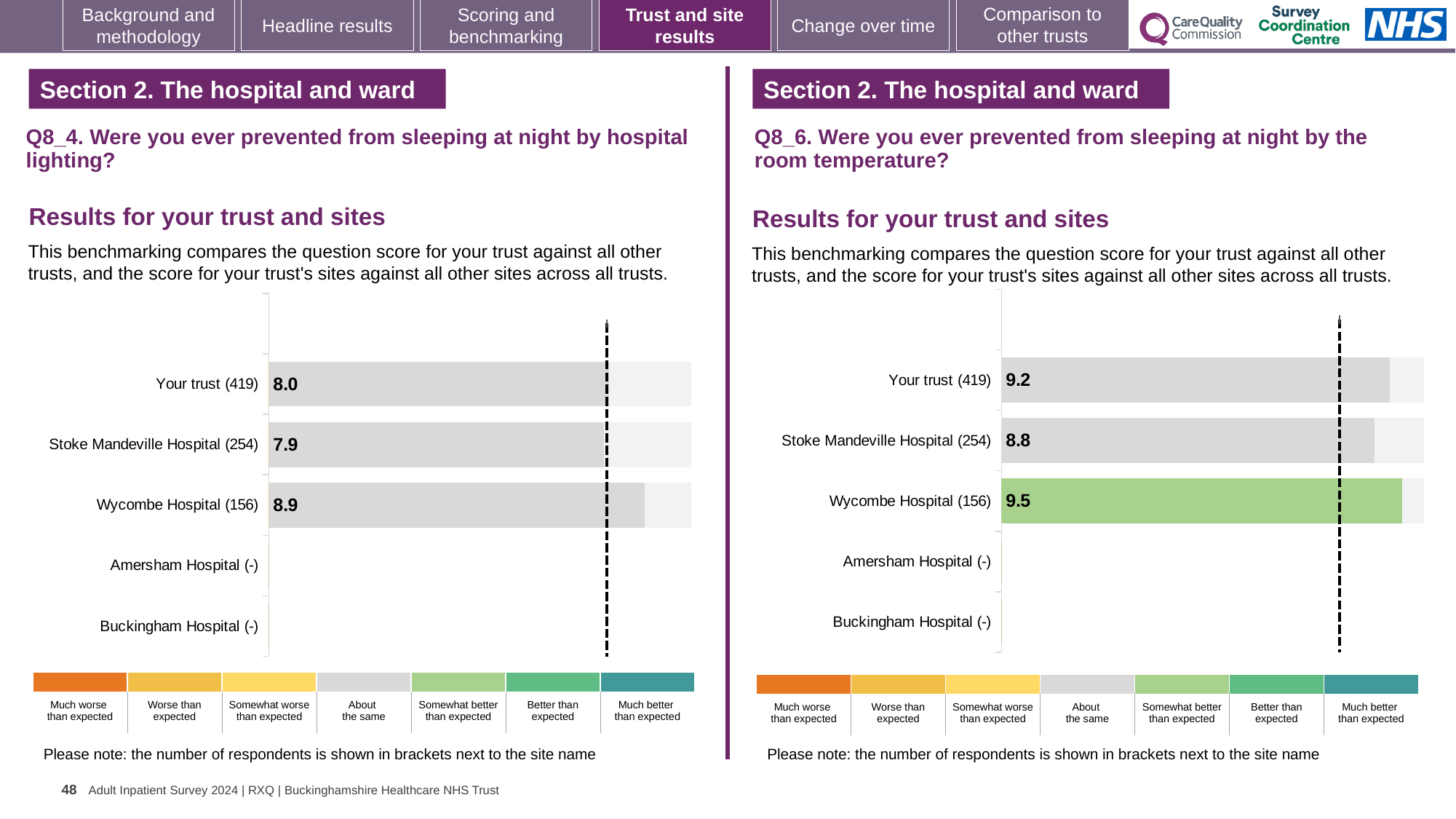
In the Q8_4 chart (hospital lighting), which has the higher score: Your trust or Wycombe Hospital? Wycombe Hospital In the Q8_6 chart (room temperature), which site has the highest score? Wycombe Hospital What type of chart is used in the Q8_6 chart (room temperature)? Bar chart In the Q8_4 chart (hospital lighting), what is the score for Stoke Mandeville Hospital? 7.9 In the Q8_4 chart (hospital lighting), what is the score for Your trust? 8.0 In the Q8_6 chart (room temperature), what is the score for Wycombe Hospital? 9.5 In the Q8_4 chart (hospital lighting), what is the score for Wycombe Hospital? 8.9 In the Q8_6 chart (room temperature), what is the difference between the scores for Wycombe Hospital and Stoke Mandeville Hospital? 0.7 In the Q8_6 chart (room temperature), what is the score for Your trust? 9.2 In the Q8_4 chart (hospital lighting), which site has the lowest score? Stoke Mandeville Hospital In the Q8_4 chart (hospital lighting), how many respondents are shown for Stoke Mandeville Hospital? 254 In the Q8_6 chart (room temperature), which site's bar is coloured green? Wycombe Hospital